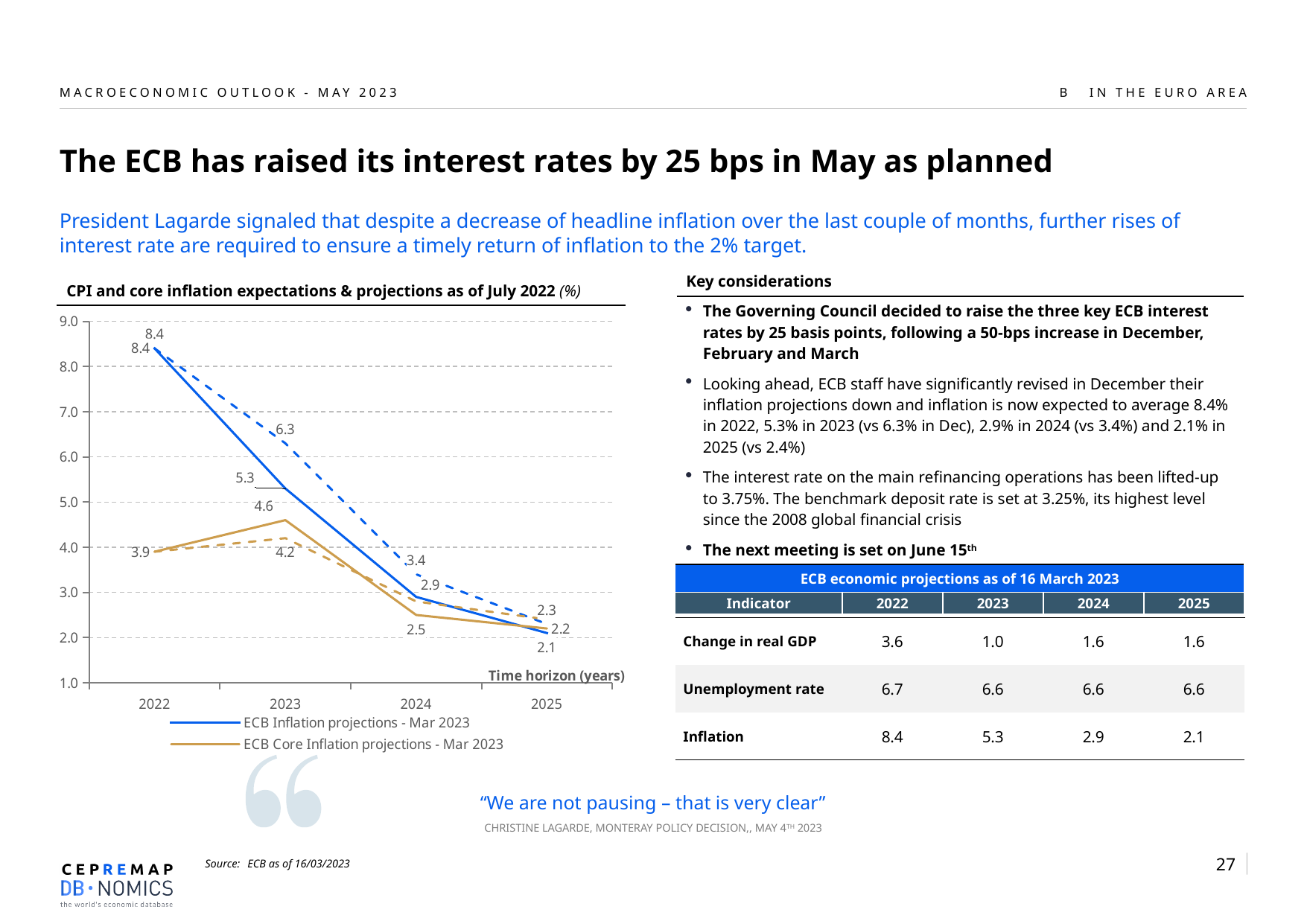
In the inflation chart, in which year is 'ECB Inflation projections - Mar 2023' highest? 2022 In the inflation chart, does 'ECB Inflation projections - Mar 2023' rise or fall from 2022 to 2025? Fall What kind of chart is shown under the title 'CPI and core inflation expectations & projections as of July 2022 (%)'? Line chart In the inflation chart, what is the difference between the 'ECB Inflation projections - Mar 2023' values for 2022 and 2023? 3.1 In the inflation chart, what is the value of 'ECB Inflation projections - Mar 2023' for 2025? 2.1 In the inflation chart, what is the value of 'ECB Core Inflation projections - Mar 2023' for 2023? 4.6 In the inflation chart, what is the value of 'ECB Core Inflation projections - Mar 2023' for 2022? 3.9 In the inflation chart, in which year is 'ECB Core Inflation projections - Mar 2023' highest? 2023 How many series does the legend of the inflation chart list? 2 In the inflation chart, which is larger for 2022: 'ECB Inflation projections - Mar 2023' or 'ECB Core Inflation projections - Mar 2023'? ECB Inflation projections - Mar 2023 How many years are shown on the x axis of the inflation chart? 4 In the inflation chart, what is the value of 'ECB Inflation projections - Mar 2023' for 2023? 5.3